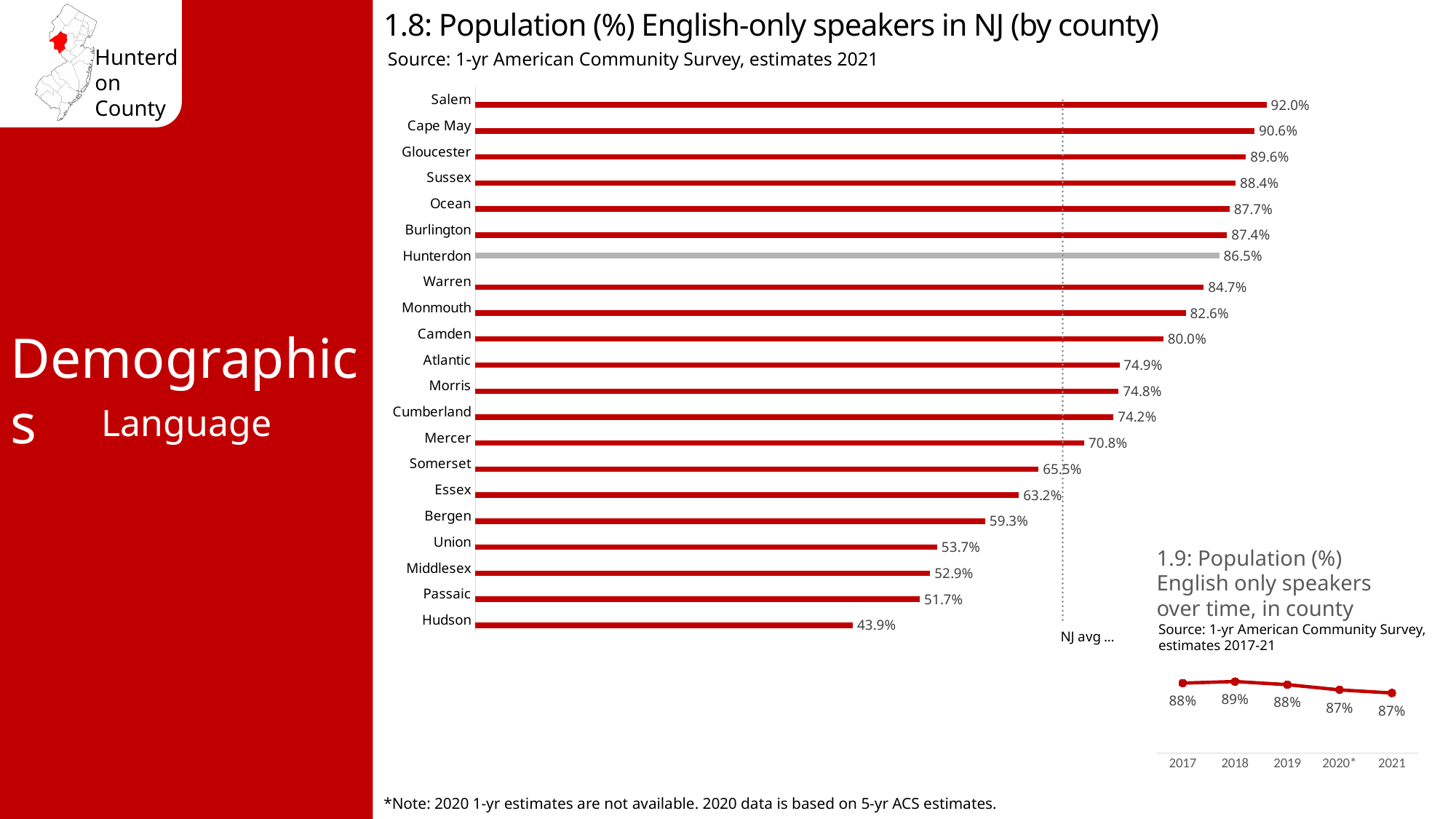
In chart 1.8, which is larger, the value for Morris or the value for Mercer? Morris In chart 1.8, what is the difference between the values for Salem and Hudson? 48.1% In chart 1.8, which county has the highest percentage of English-only speakers? Salem In chart 1.8, what is the value for Bergen? 59.3% In chart 1.8, which county has the lowest percentage of English-only speakers? Hudson In chart 1.8, what is the value for Hunterdon? 86.5% In chart 1.9, how many data points are plotted? 5 In chart 1.8, how many counties are shown? 21 In chart 1.9, do the values rise or fall from 2018 to 2021? Fall In chart 1.8, which county's bar is shown in grey instead of red? Hunterdon What kind of chart is chart 1.8? Bar chart In chart 1.9, what is the value for 2018? 89%